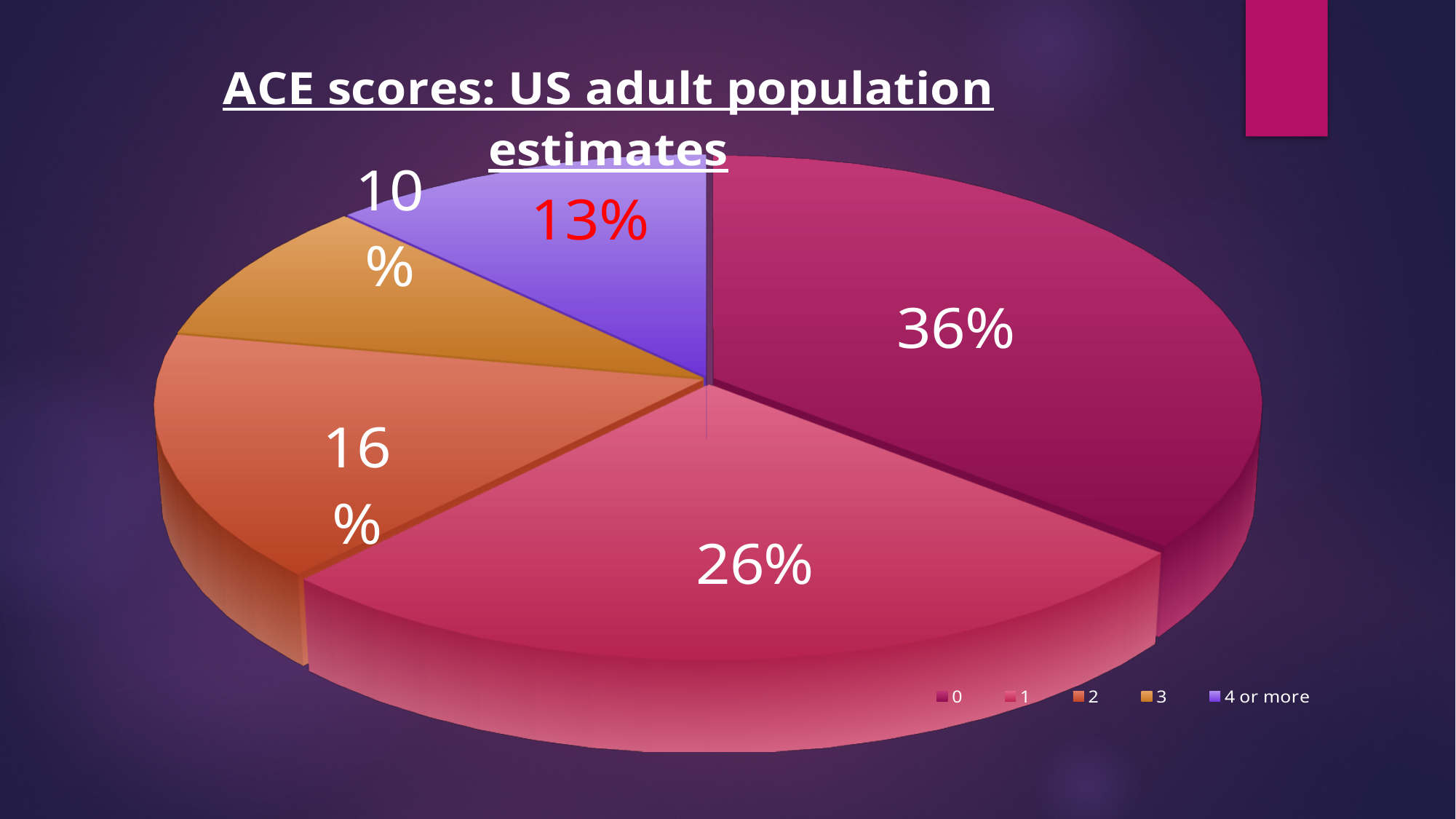
Which slice is larger, ACE score 2 or '4 or more'? 2 Which ACE score category has the largest slice? 0 What share of the pie does the ACE score 3 slice represent? 10% What is the title of the chart? ACE scores: US adult population estimates What share of the pie does the ACE score 2 slice represent? 16% What share of the pie does the '4 or more' slice represent? 13% How many categories does the legend list? 5 Which ACE score category has the smallest slice? 3 What is the difference in percentage points between the ACE score 0 slice and the ACE score 1 slice? 10 What kind of chart is shown on the slide? pie chart What share of the pie does the ACE score 1 slice represent? 26% What share of the pie does the ACE score 0 slice represent? 36%